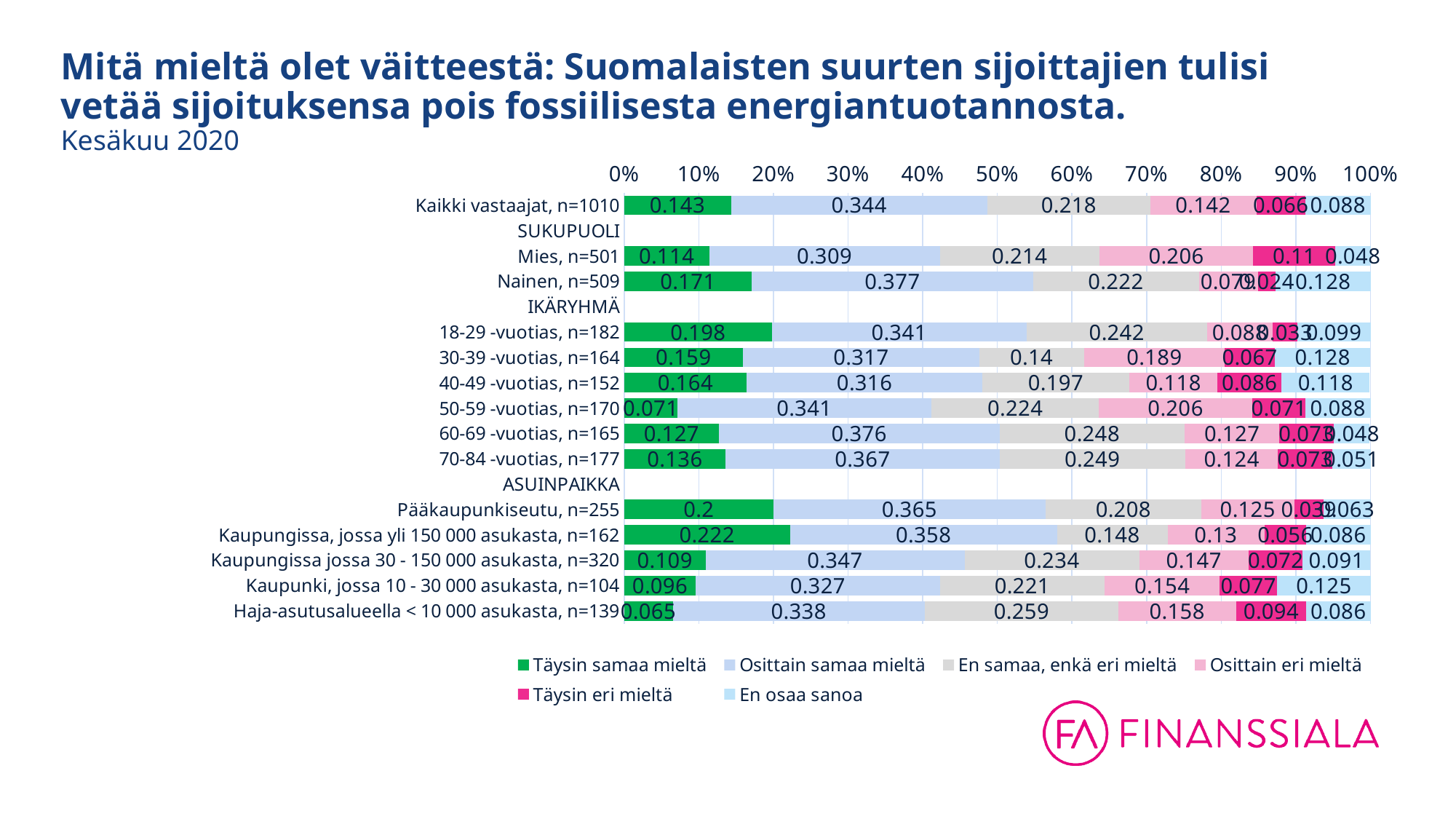
Among the age groups (IKÄRYHMÄ), which has the highest "Täysin samaa mieltä" value? 18-29 -vuotias, n=182 What is the difference between the "Täysin samaa mieltä" values for Nainen, n=509 and Mies, n=501? 0.057 What is the value for "Osittain eri mieltä" for 30-39 -vuotias, n=164? 0.189 What is the value for "Osittain samaa mieltä" for Nainen, n=509? 0.377 Which has the larger "Osittain eri mieltä" value, Mies, n=501 or Nainen, n=509? Mies, n=501 What is the value for "Täysin eri mieltä" for Haja-asutusalueella < 10 000 asukasta, n=139? 0.094 How many respondent groups (bars) are plotted in the chart? 14 Among the residence groups (ASUINPAIKKA), which has the lowest "Täysin samaa mieltä" value? Haja-asutusalueella < 10 000 asukasta, n=139 How many series does the legend list? 6 What is the value for "En samaa, enkä eri mieltä" for Haja-asutusalueella < 10 000 asukasta, n=139? 0.259 What is the value for "Täysin samaa mieltä" for Kaikki vastaajat, n=1010? 0.143 What kind of chart is shown on the slide? Stacked bar chart